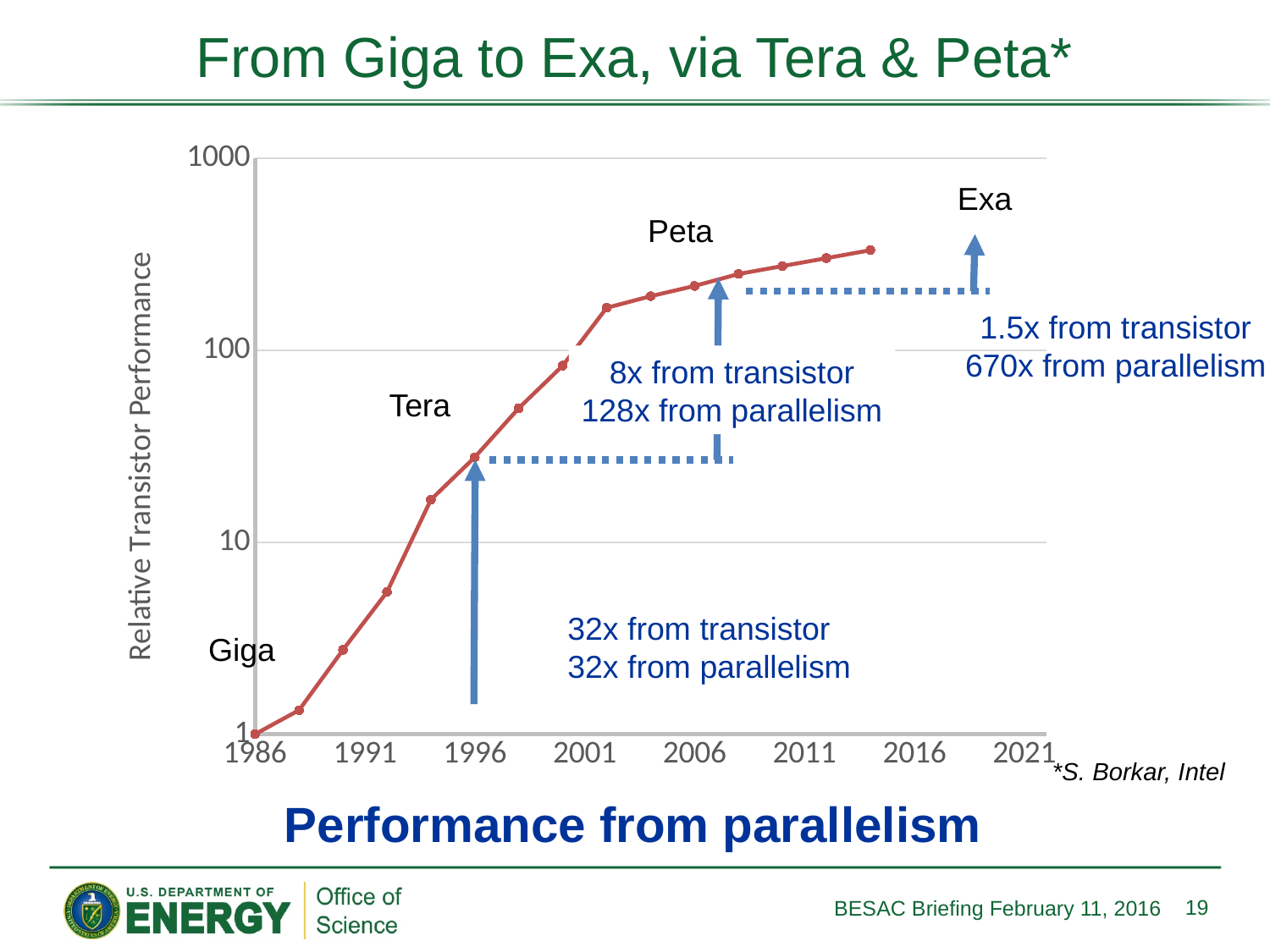
What is the title of the y axis? Relative Transistor Performance Is the value plotted for 1996 greater or less than 100? less According to the annotation, how much performance comes from the transistor at the Exa step? 1.5x Is the value plotted for 2006 greater or less than 100? greater Which of the labeled milestones (Giga, Tera, Peta, Exa) sits at the highest performance level on the chart? Exa Is the value plotted for 2006 greater or less than 1000? less Which of the labeled milestones (Giga, Tera, Peta, Exa) sits at the lowest performance level on the chart? Giga What kind of chart is shown on the slide? line chart According to the annotation, how much performance comes from parallelism at the Peta step? 128x What is the relative transistor performance value plotted for 1986? 1 Do the plotted values rise or fall from 1986 to the right end of the x axis? rise